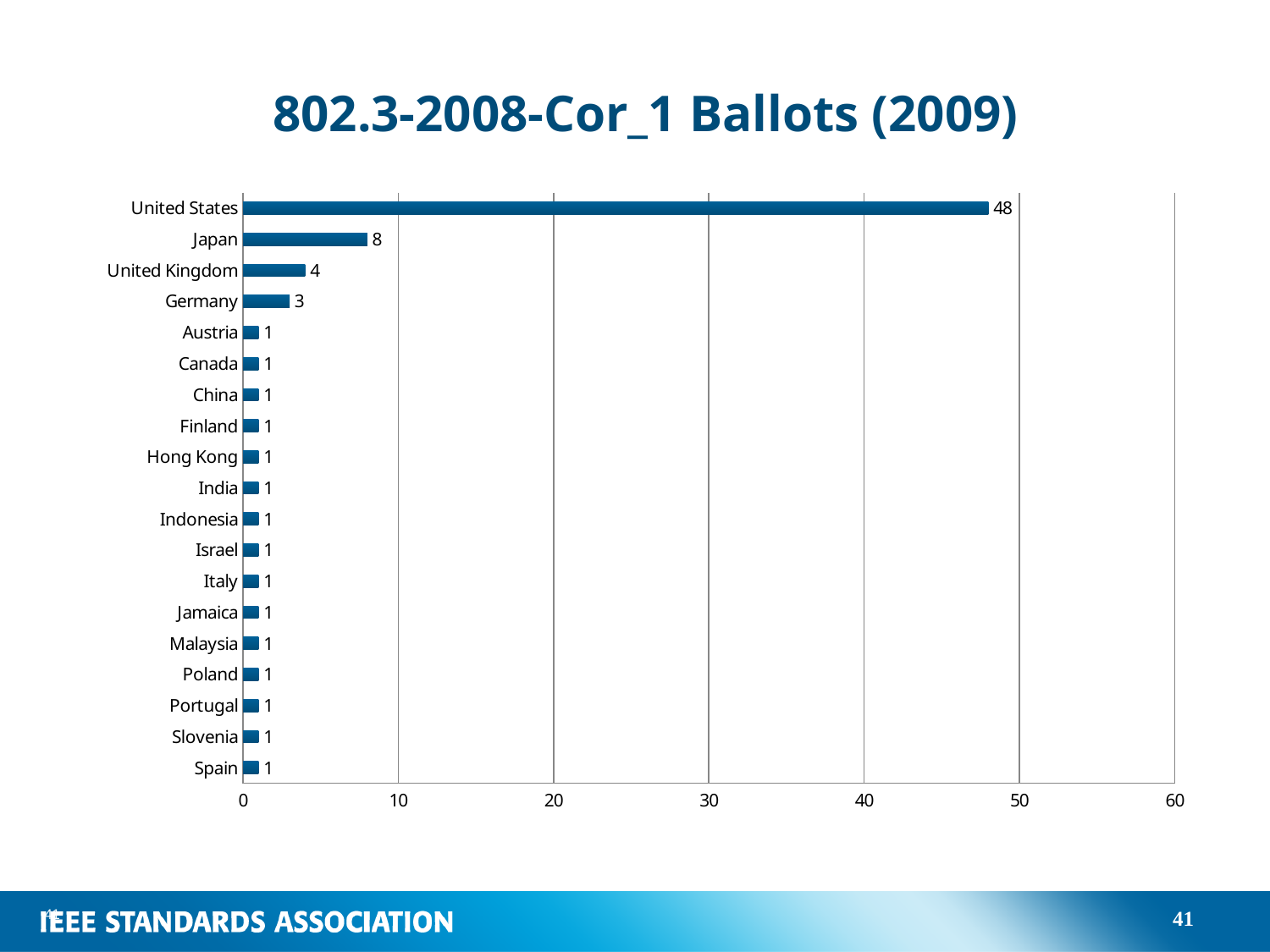
What is the value for Japan? 8 How many categories are shown in the chart? 19 Which is larger, the value for United Kingdom or the value for Germany? United Kingdom Is the value for United States greater or less than 40? greater What is the value for United States? 48 What is the value for Germany? 3 What is the value for Hong Kong? 1 What is the value for United Kingdom? 4 What is the difference between the values for United States and Japan? 40 What kind of chart is shown on the slide? Bar chart What is the difference between the values for Japan and Germany? 5 Which category has the highest value? United States